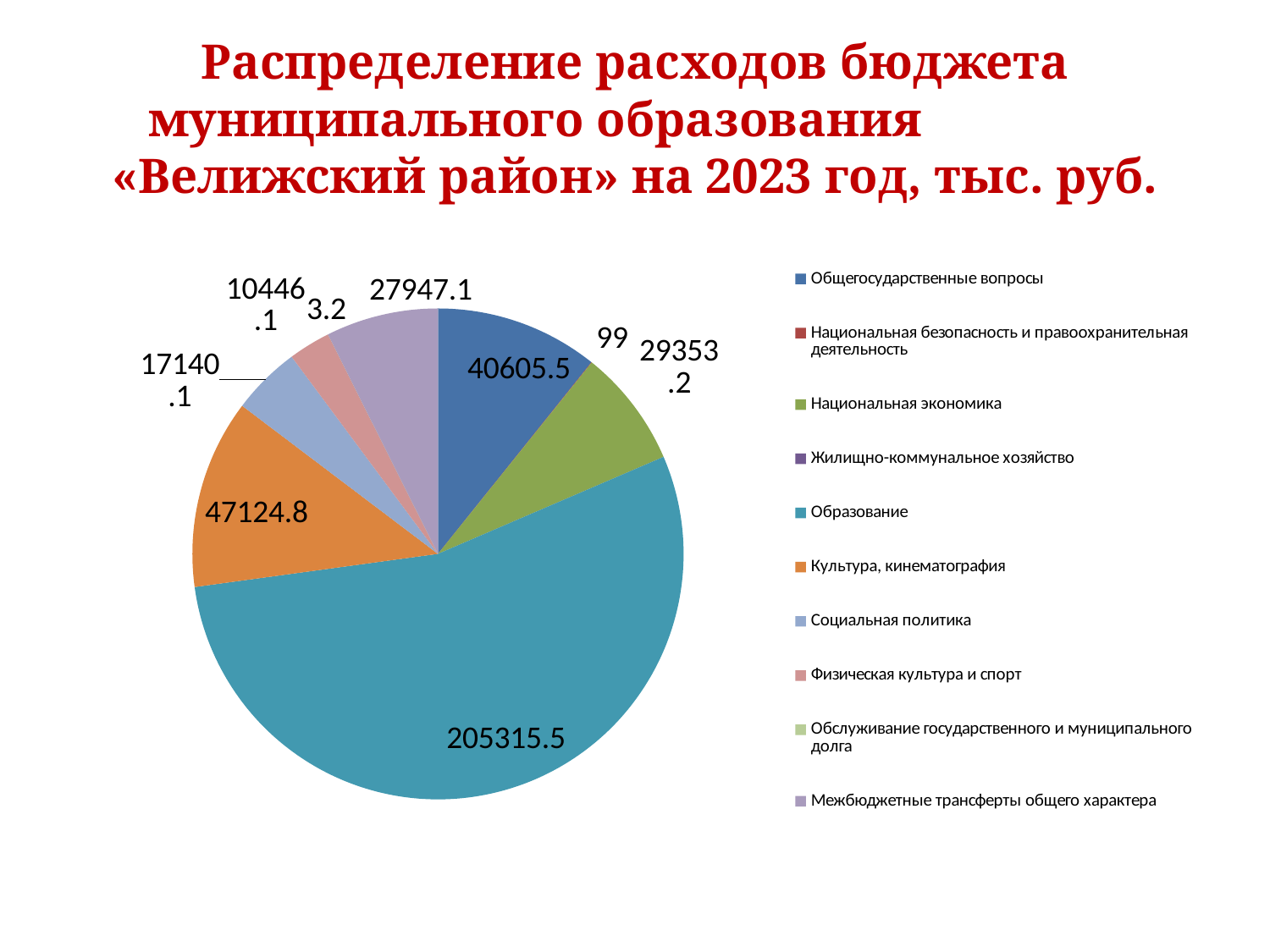
What is the value for Образование? 205315.5 What is the value for Общегосударственные вопросы? 40605.5 What is the value for Национальная экономика? 29353.2 How many entries does the legend list? 10 What is the value for Социальная политика? 17140.1 What is the value for Межбюджетные трансферты общего характера? 27947.1 What colour is the slice for Образование? Teal Which is larger: Культура, кинематография or Общегосударственные вопросы? Культура, кинематография What is the difference between Культура, кинематография and Общегосударственные вопросы? 6519.3 What kind of chart is shown on the slide? Pie chart What is the value for Культура, кинематография? 47124.8 Which category has the largest slice of the pie? Образование